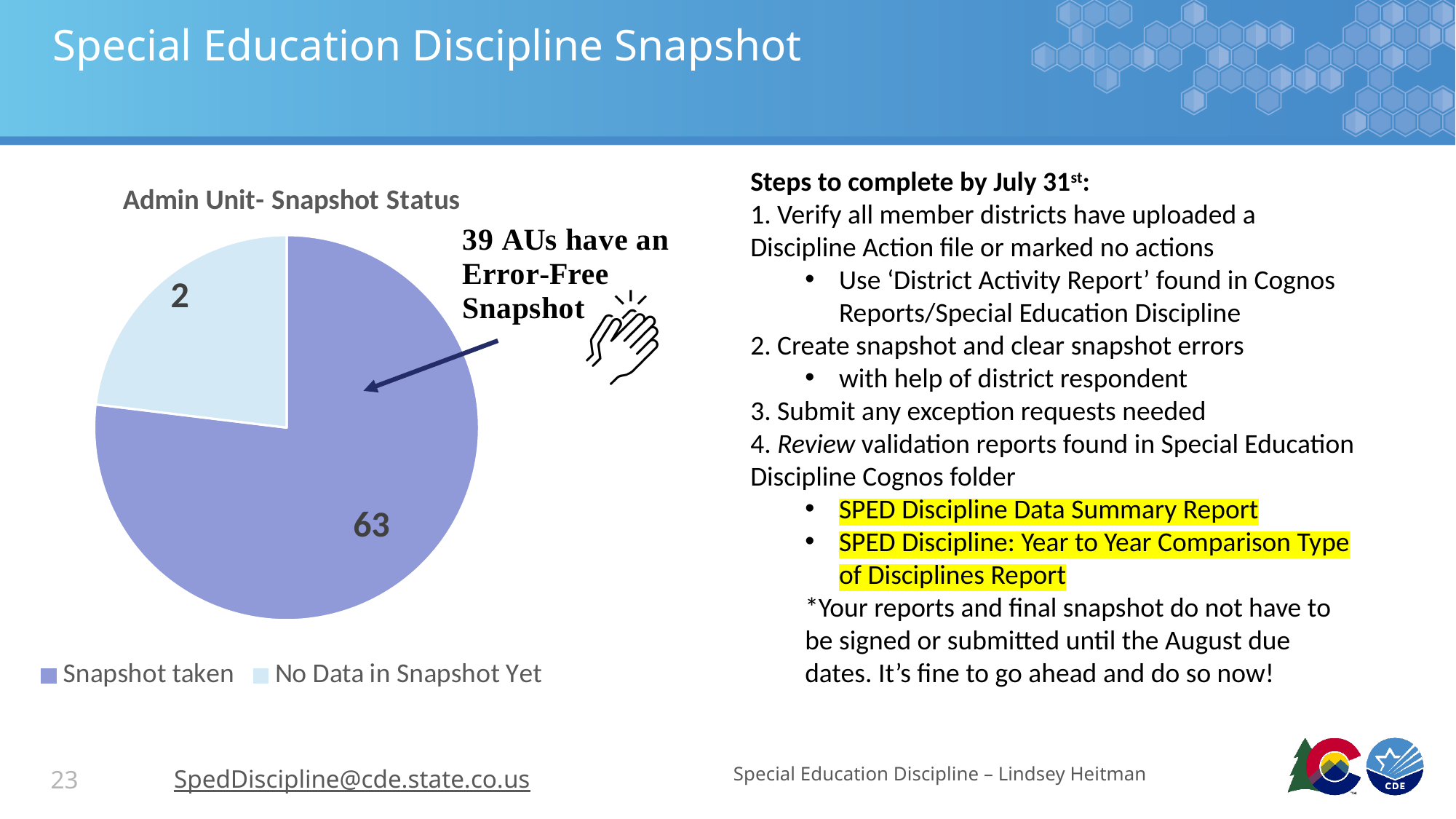
What is the value for 'Snapshot taken' in the pie chart? 63 What is the total of the two values shown in the pie chart? 65 How many categories does the pie chart show? 2 Which is larger: the value for 'Snapshot taken' or the value for 'No Data in Snapshot Yet'? Snapshot taken Which category has the smallest slice in the pie chart? No Data in Snapshot Yet Which colour represents 'No Data in Snapshot Yet' in the pie chart? Light blue What is the value for 'No Data in Snapshot Yet' in the pie chart? 2 How many entries does the chart legend list? 2 Which category has the largest slice in the pie chart? Snapshot taken What type of chart is shown on the slide? Pie chart What is the title of the chart on the slide? Admin Unit- Snapshot Status What is the difference between the 'Snapshot taken' value and the 'No Data in Snapshot Yet' value? 61